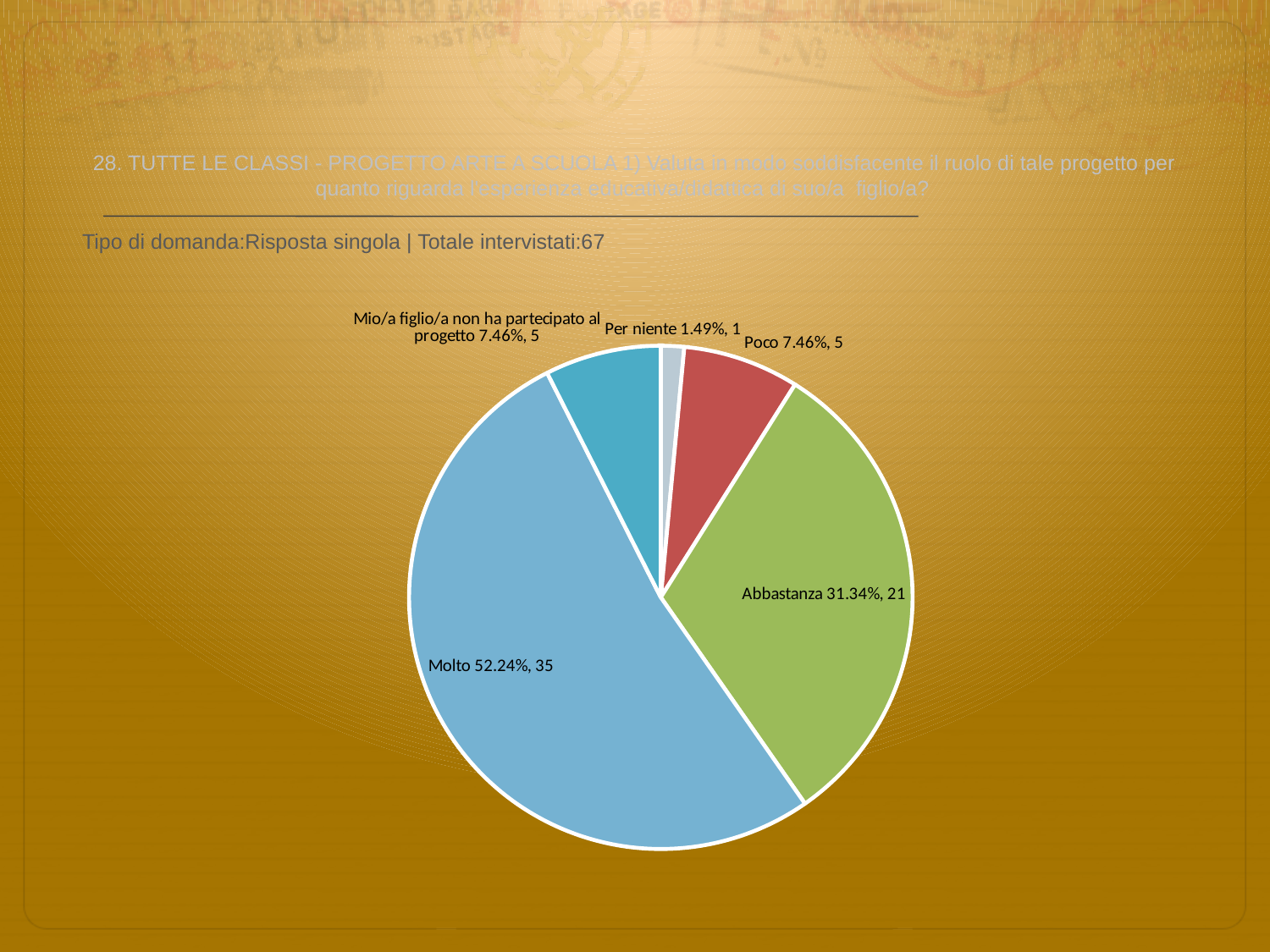
How many respondents answered 'Per niente'? 1 How many respondents answered 'Abbastanza'? 21 How many slices does the pie chart have? 5 Which category has the smallest slice of the pie? Per niente What percentage share does the 'Molto' slice have? 52.24% Which category has the largest slice of the pie? Molto What percentage share does the 'Abbastanza' slice have? 31.34% What is the difference in respondent count between 'Molto' and 'Abbastanza'? 14 What kind of chart is shown on the slide? pie chart What is the total number of respondents (Totale intervistati) stated on the slide? 67 Which has more respondents, 'Poco' or 'Abbastanza'? Abbastanza What percentage share does the 'Poco' slice have? 7.46%